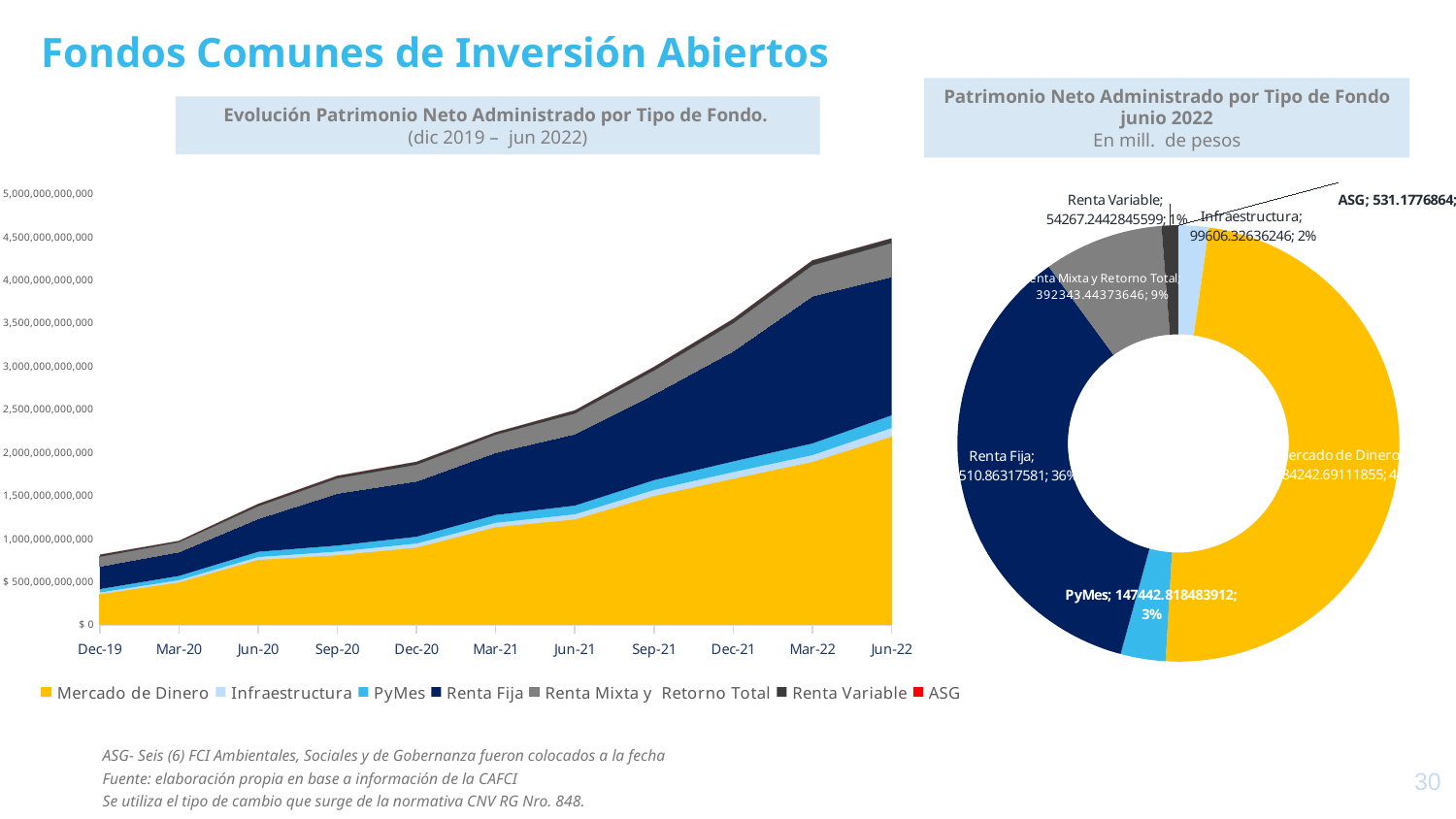
What type of chart is the left chart, 'Evolución Patrimonio Neto Administrado por Tipo de Fondo'? Stacked area chart In the right chart, what is the value shown for Infraestructura? 99606.32636246 In the right chart, what share of the total does Renta Mixta y Retorno Total represent? 9% How many series does the legend list? 7 What type of chart is the right chart, 'Patrimonio Neto Administrado por Tipo de Fondo junio 2022'? Donut (pie) chart In the left chart, is the total value at Jun-22 greater or less than 4,000,000,000,000? greater In the right chart, which fund type has the largest slice? Mercado de Dinero In the right chart, what is the value shown for PyMes? 147442.818483912 In the left chart, is the total value at Dec-19 greater or less than 1,000,000,000,000? less In the left chart, does the total net worth rise or fall from Dec-19 to Jun-22? Rises In the right chart, which is larger, Renta Fija or Mercado de Dinero? Mercado de Dinero In the left chart, how many dates are shown on the x axis? 11